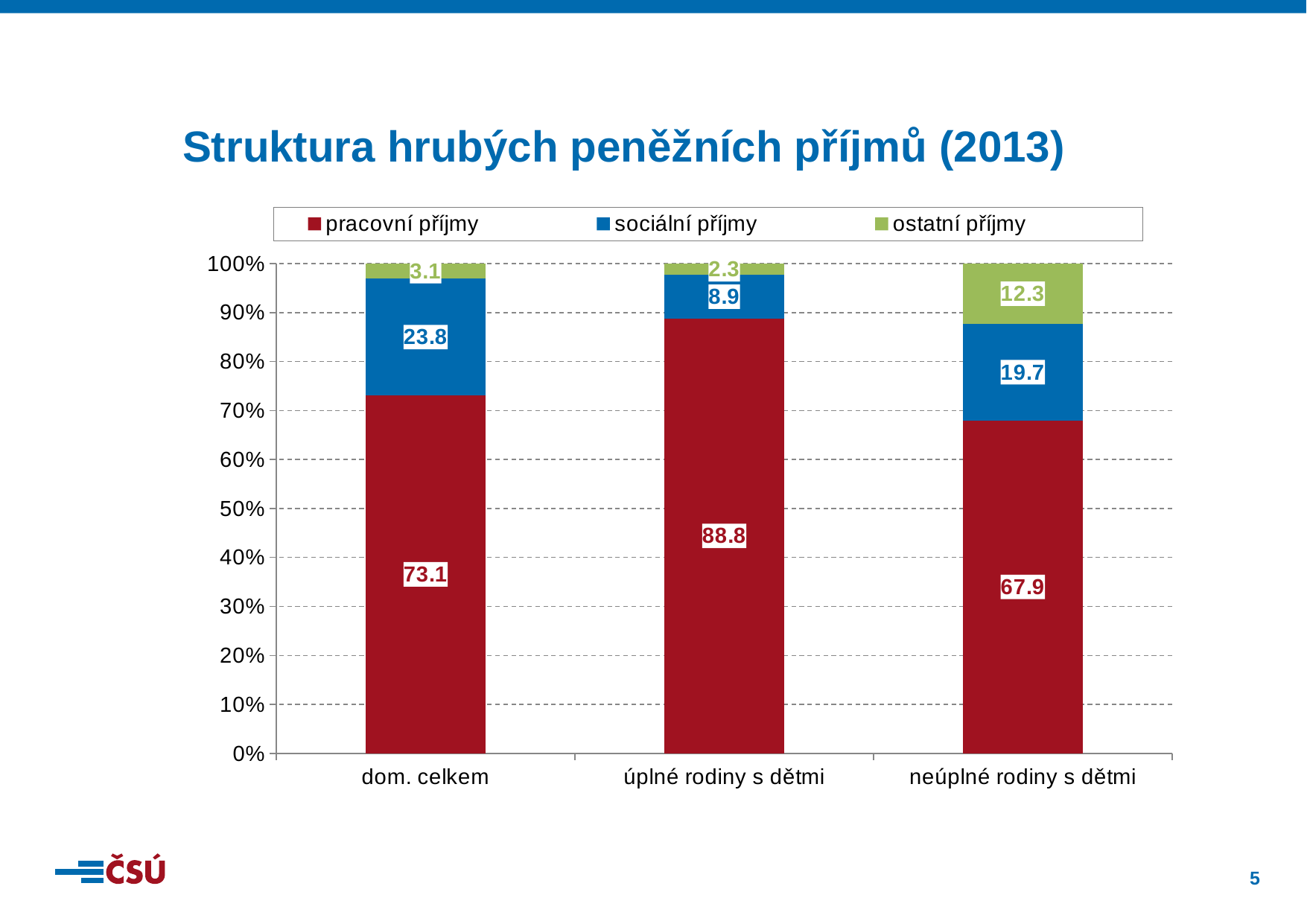
Which category has the lowest value of sociální příjmy? úplné rodiny s dětmi What is the value of ostatní příjmy for úplné rodiny s dětmi? 2.3 What is the value of sociální příjmy for neúplné rodiny s dětmi? 19.7 What is the title of the chart? Struktura hrubých peněžních příjmů (2013) Which category has the highest value of pracovní příjmy? úplné rodiny s dětmi Which is larger: ostatní příjmy for dom. celkem or for neúplné rodiny s dětmi? neúplné rodiny s dětmi Which colour represents sociální příjmy in the chart? blue What is the difference between the pracovní příjmy values for úplné rodiny s dětmi and neúplné rodiny s dětmi? 20.9 What is the value of pracovní příjmy for dom. celkem? 73.1 How many series does the legend list? 3 What kind of chart is shown on the slide? stacked bar chart How many categories are shown on the x axis? 3